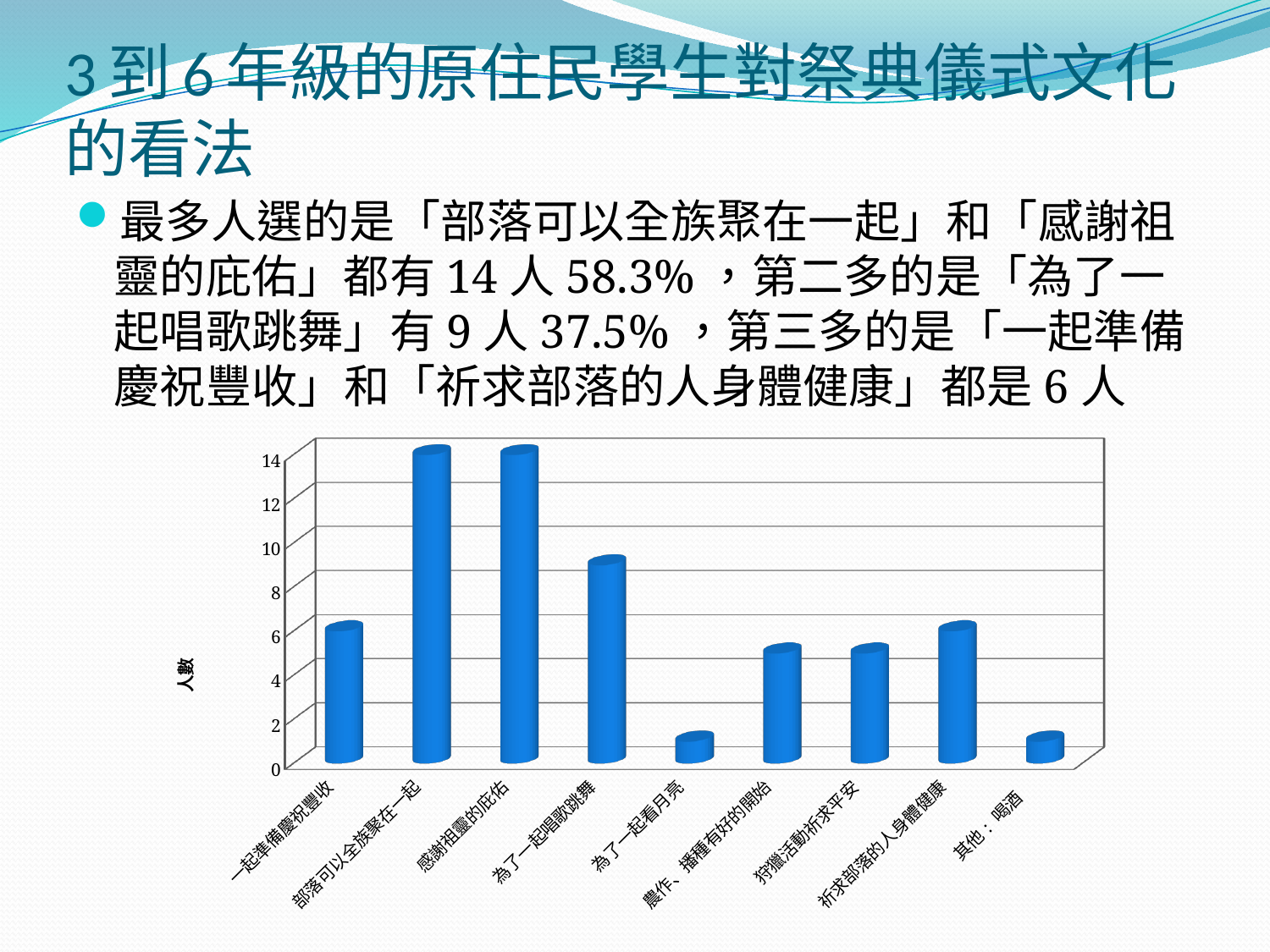
What is the difference between the values for 部落可以全族聚在一起 and 為了一起唱歌跳舞? 5 What is the value for 感謝祖靈的庇佑? 14 How many categories are shown on the x axis of the chart? 9 What is the label on the vertical axis of the chart? 人數 What is the value for 部落可以全族聚在一起? 14 Is the value for 為了一起看月亮 greater or less than 2? less What is the value for 為了一起唱歌跳舞? 9 What is the value for 祈求部落的人身體健康? 6 Is the value for 狩獵活動祈求平安 greater or less than 6? less Which is larger, the value for 為了一起唱歌跳舞 or the value for 一起準備慶祝豐收? 為了一起唱歌跳舞 What is the value for 一起準備慶祝豐收? 6 What type of chart is shown on the slide? bar chart